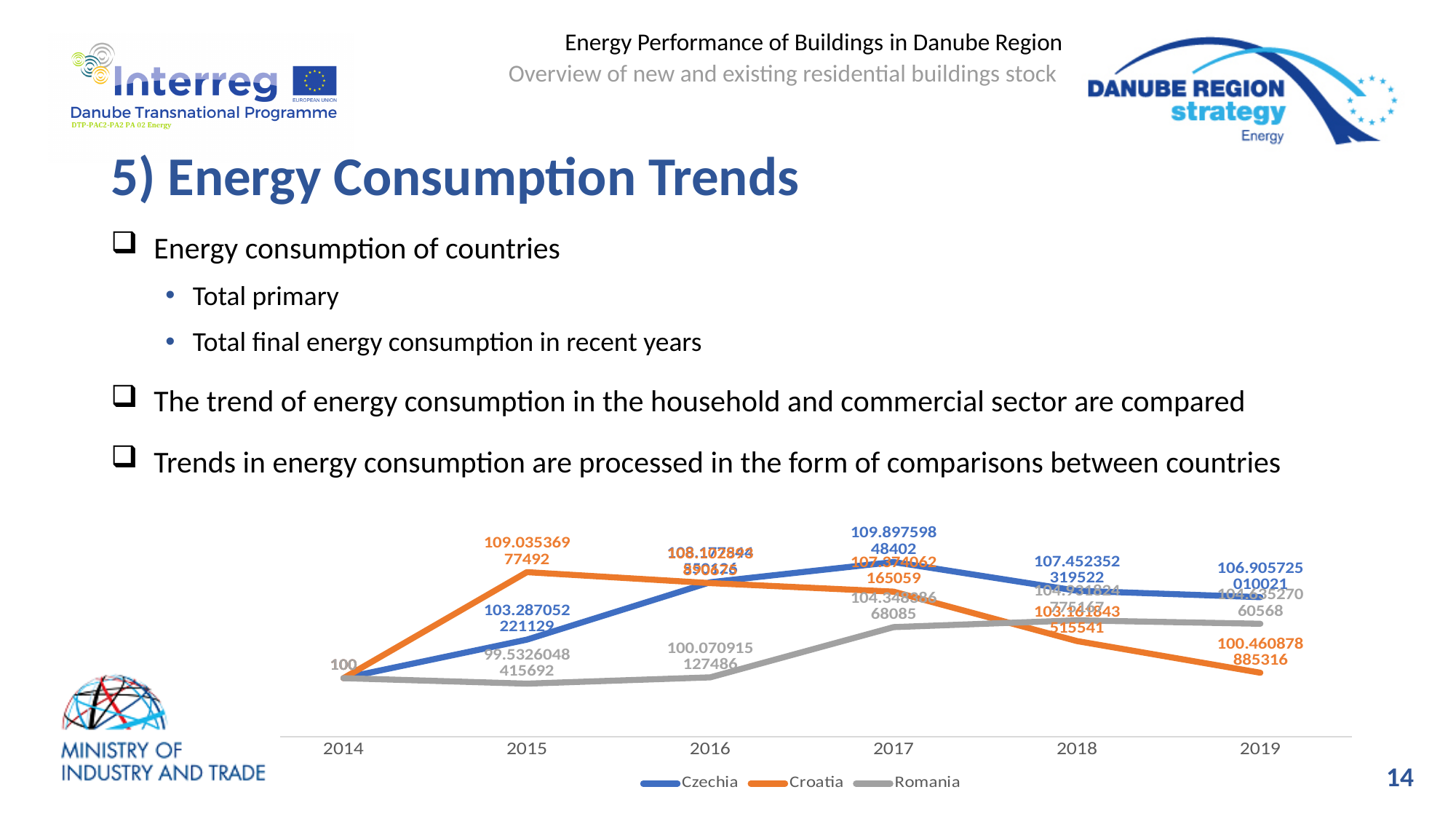
How many years are shown on the x axis of the chart? 6 How many series does the chart legend list? 3 What is the value for Czechia in 2017? 109.89759848402 What type of chart is shown on the slide? line chart Which series has the larger value in 2019, Czechia or Croatia? Czechia What is the difference between the Czechia and Croatia values in 2019? 6.444846124705 What is the value for Croatia in 2019? 100.460878885316 Does the Croatia line rise or fall from 2017 to 2019? fall In which year does Romania have its lowest value? 2015 What is the value for Czechia in 2015? 103.287052221129 In which year does Croatia reach its highest value? 2015 What is the value for Romania in 2015? 99.5326048415692